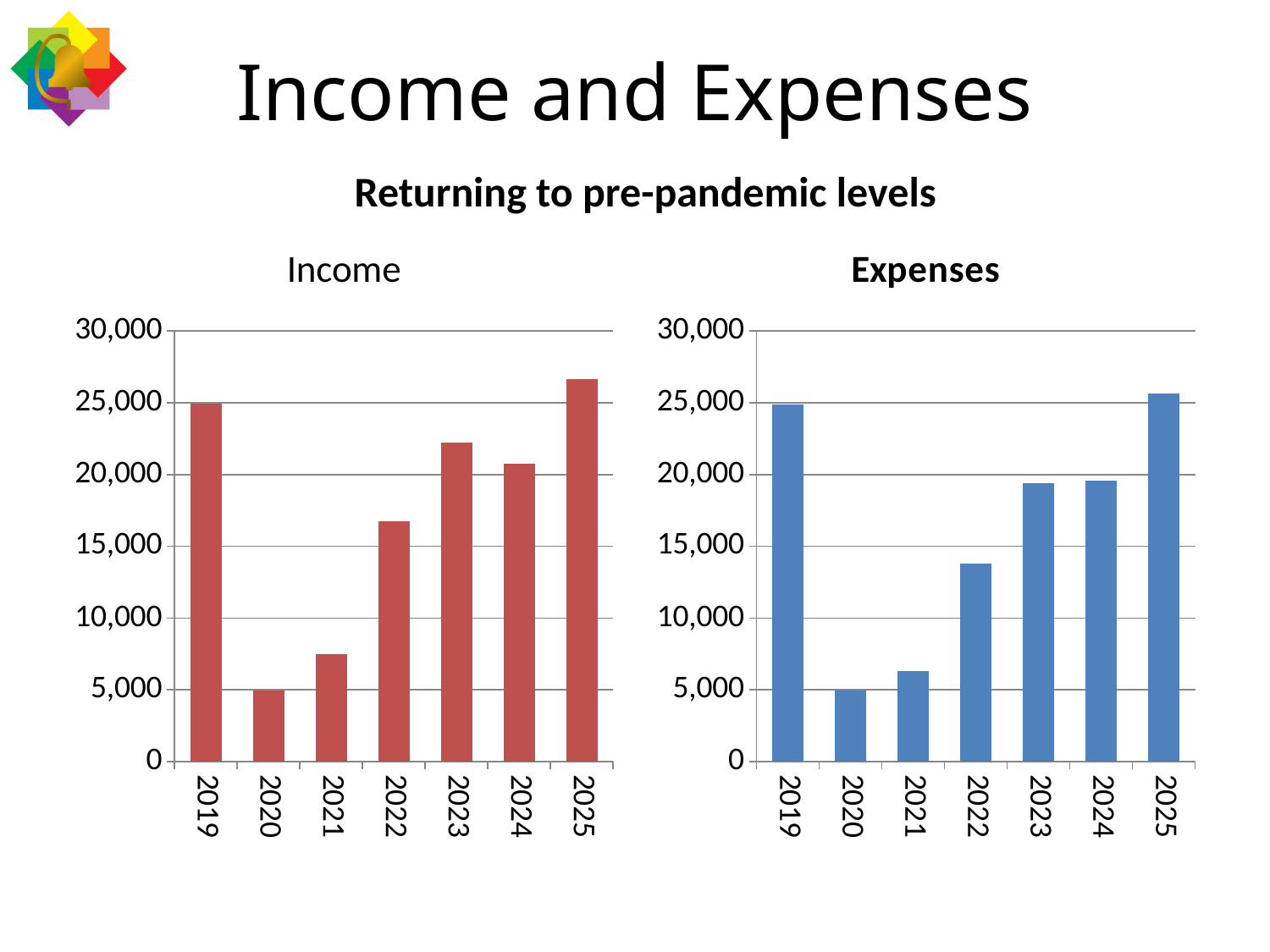
In the Income chart, is the value for 2022 greater or less than 15,000? greater In the Expenses chart, which year has the lowest expenses? 2020 What colour are the bars in the Expenses chart? blue What kind of chart is the Income chart? bar chart In the Expenses chart, which year has the highest expenses? 2025 In the Expenses chart, is the value for 2022 greater or less than 15,000? less How many years are shown on the Expenses chart? 7 In the Income chart, which year has the lowest income? 2020 In the Expenses chart, is the value for 2023 greater or less than 20,000? less In the Income chart, which year has the highest income? 2025 In the Income chart, do the values rise or fall from 2020 to 2023? rise In the Income chart, which year has the larger value, 2023 or 2024? 2023